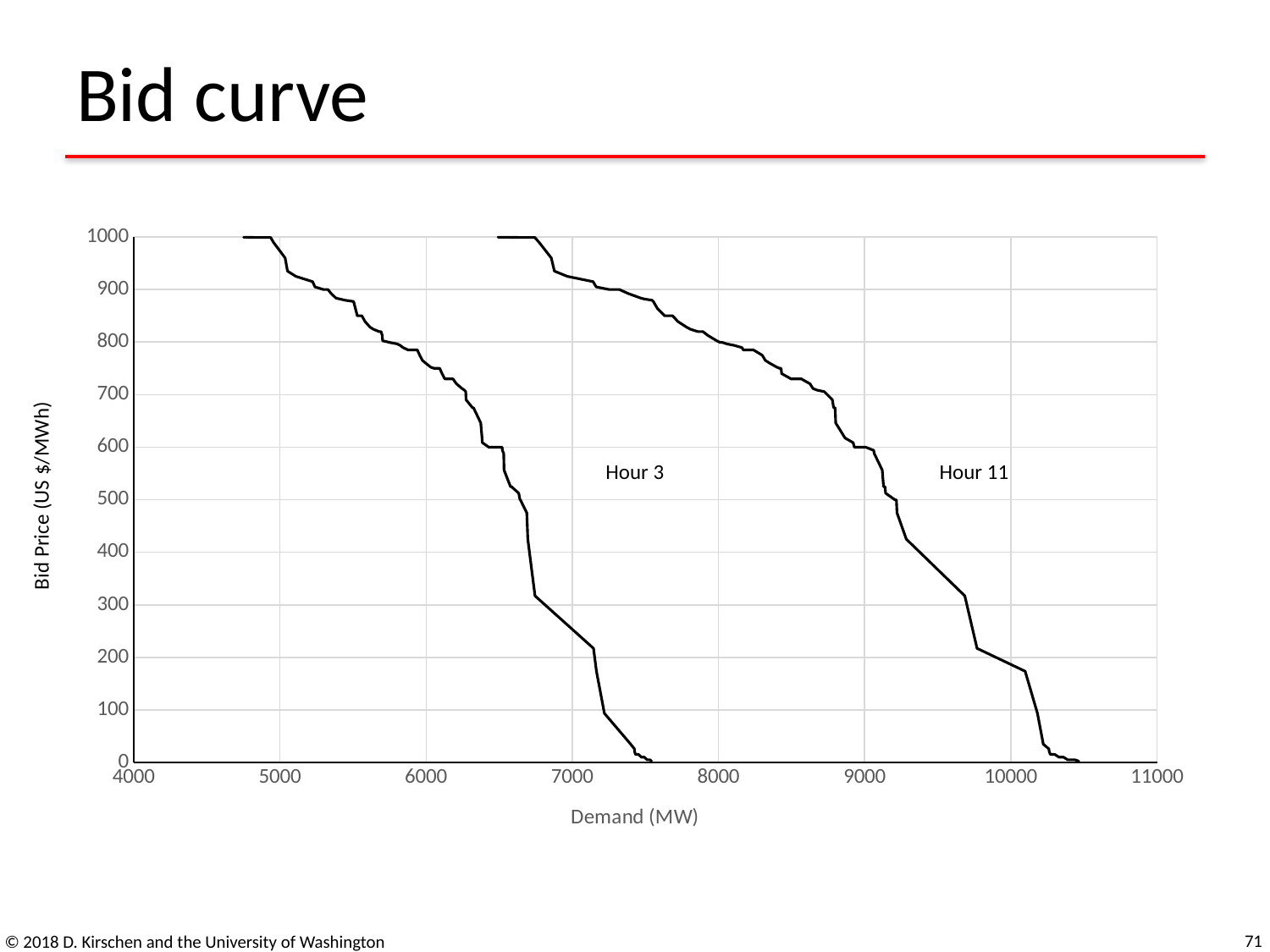
Is the demand at which the Hour 3 curve reaches a bid price of 0 greater or less than 7000 MW? greater What is the label of the x axis? Demand (MW) What is the title of the chart on the slide? Bid curve As demand increases along the x axis, does the bid price rise or fall? Fall How many curves are plotted on the chart? 2 Is the demand at which the Hour 3 curve reaches a bid price of 500 greater or less than 7000 MW? less Is the demand at which the Hour 11 curve reaches a bid price of 500 greater or less than 9000 MW? greater What kind of chart is shown on the slide? Line chart Which curve lies further to the right on the chart, Hour 3 or Hour 11? Hour 11 At a bid price of 500 US $/MWh, which curve corresponds to the larger demand, Hour 3 or Hour 11? Hour 11